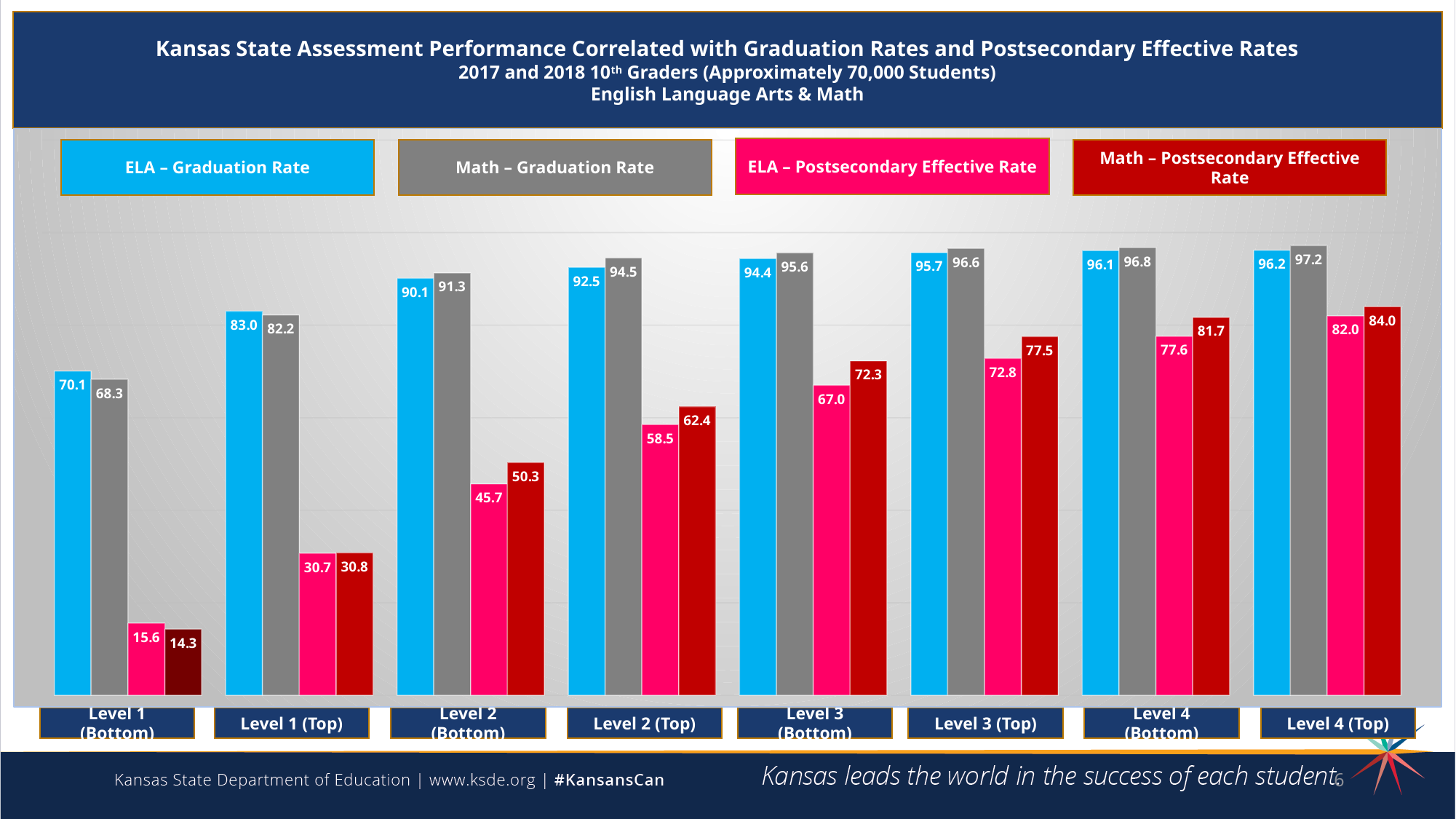
What is the difference between the Math – Graduation Rate and the Math – Postsecondary Effective Rate for Level 3 (Top)? 19.1 How many series does the legend list? 4 Which colour represents the ELA – Graduation Rate series? Blue What is the ELA – Postsecondary Effective Rate for Level 2 (Top)? 58.5 Do the Math – Postsecondary Effective Rate values rise or fall from Level 1 (Bottom) to Level 4 (Top)? Rise What kind of chart is shown on the slide? Bar chart What is the Math – Postsecondary Effective Rate for Level 4 (Top)? 84.0 Which category has the highest Math – Graduation Rate? Level 4 (Top) What is the ELA – Graduation Rate for Level 1 (Bottom)? 70.1 Which category has the lowest ELA – Postsecondary Effective Rate? Level 1 (Bottom) For Level 1 (Top), which is larger: the ELA – Graduation Rate or the Math – Graduation Rate? ELA – Graduation Rate How many categories are shown on the x axis? 8